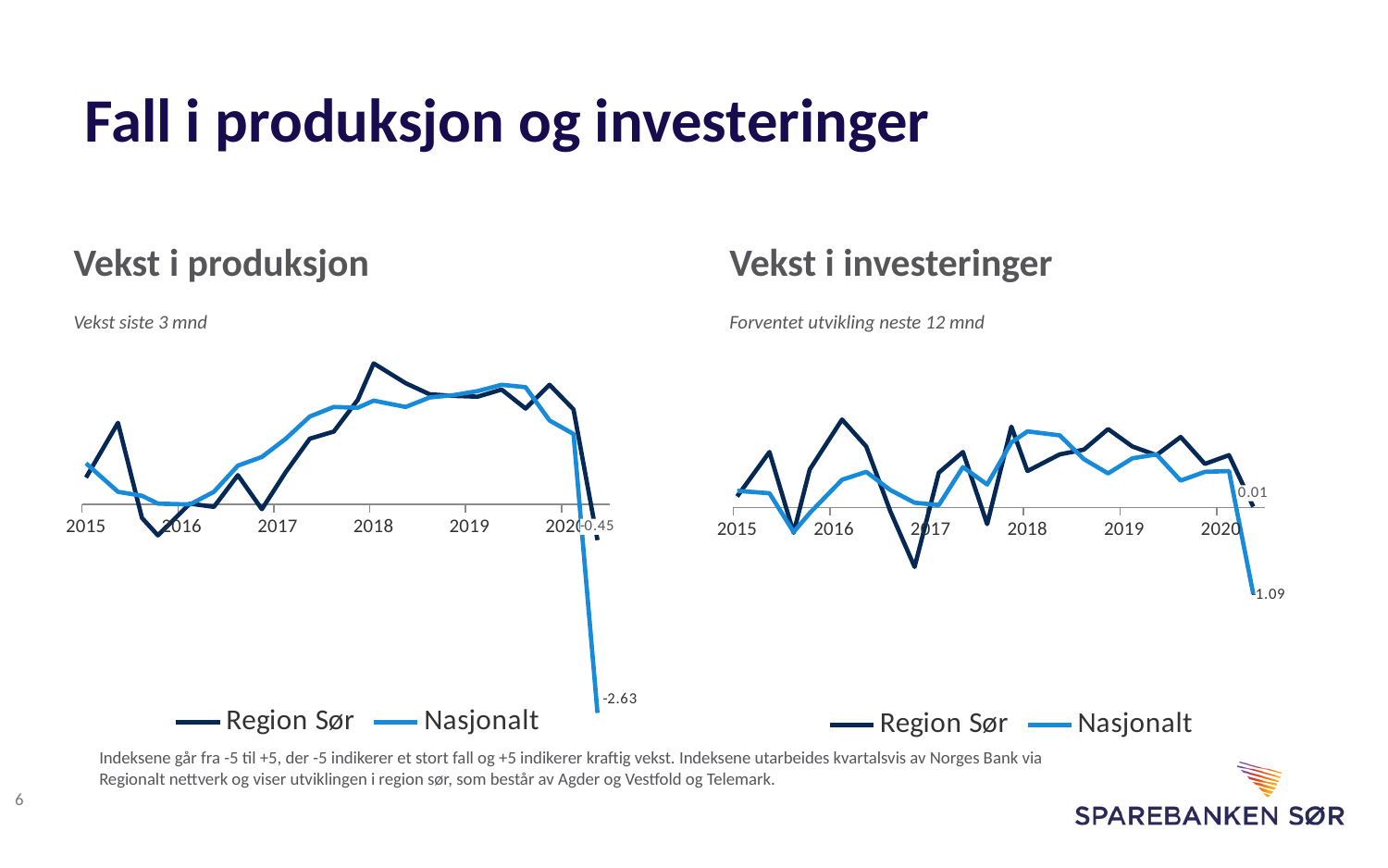
What are the two legend entries of the 'Vekst i produksjon' chart? Region Sør and Nasjonalt What kind of chart is the 'Vekst i produksjon' chart? Line chart How many series does the legend of the 'Vekst i investeringer' chart list? 2 How many year labels are shown on the x axis of the 'Vekst i produksjon' chart? 6 In the 'Vekst i investeringer' chart, what is the labelled final value for Region Sør? 0.01 In the 'Vekst i produksjon' chart, what is the labelled final value for Nasjonalt? -2.63 What is the subtitle shown under the 'Vekst i investeringer' chart title? Forventet utvikling neste 12 mnd In the 'Vekst i produksjon' chart, does the Nasjonalt line rise or fall between 2016 and 2018? Rise In the 'Vekst i produksjon' chart, what is the difference between the final Region Sør value (-0.45) and the final Nasjonalt value (-2.63)? 2.18 In the 'Vekst i produksjon' chart, which series has the higher value at the final data point, Region Sør or Nasjonalt? Region Sør In the 'Vekst i produksjon' chart, what is the labelled final value for Region Sør? -0.45 In the 'Vekst i investeringer' chart, which series is higher at the final data point, Region Sør or Nasjonalt? Region Sør